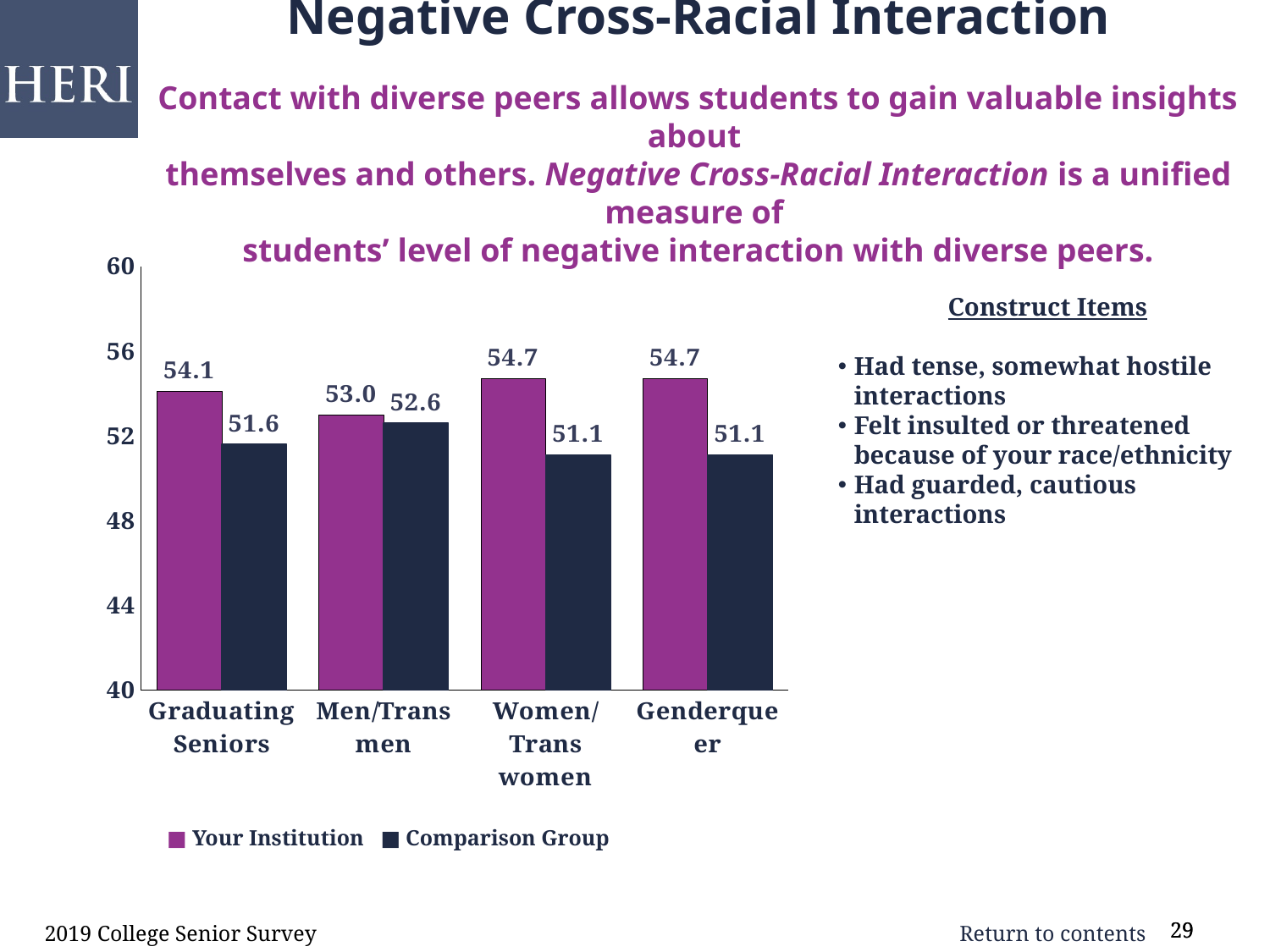
Which category has the highest Comparison Group value? Men/Trans men What is the difference between the Your Institution and Comparison Group values for Graduating Seniors? 2.5 What is the Your Institution value for Women/Trans women? 54.7 Which is larger for Men/Trans men: the Your Institution value or the Comparison Group value? Your Institution What is the Comparison Group value for Genderqueer? 51.1 How many series does the legend list? 2 What kind of chart is shown on the slide? Bar chart What is the Your Institution value for Graduating Seniors? 54.1 How many categories are shown on the x axis? 4 Which category has the lowest Your Institution value? Men/Trans men What is the Comparison Group value for Men/Trans men? 52.6 What is the difference between the Your Institution and Comparison Group values for Women/Trans women? 3.6